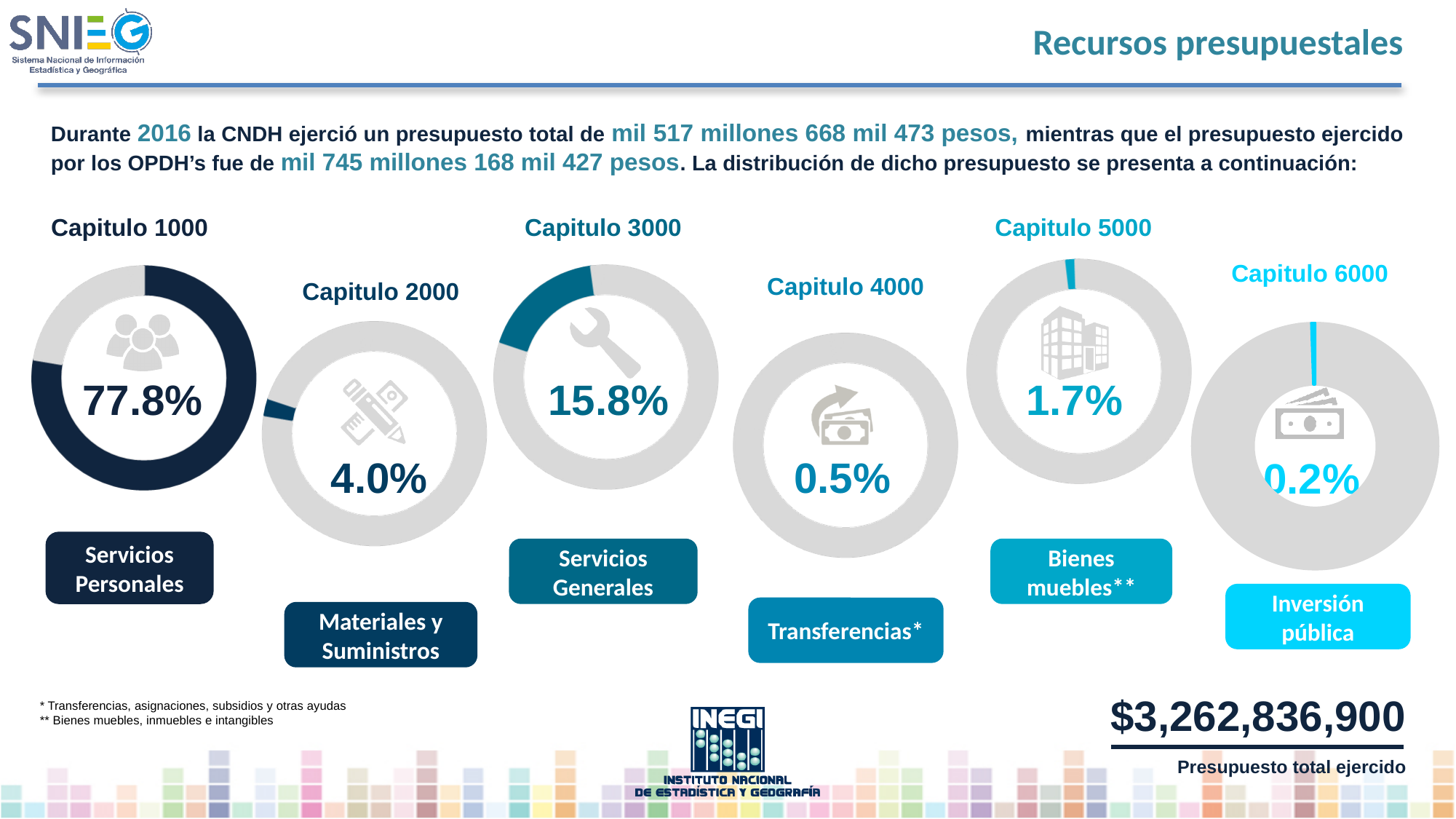
What percentage is shown in the Capitulo 1000 (Servicios Personales) donut chart? 77.8% Which capítulo has the lowest share of the budget across the donut charts? Capitulo 6000 (Inversión pública) What percentage is shown in the Capitulo 6000 (Inversión pública) donut chart? 0.2% What percentage is shown in the Capitulo 5000 (Bienes muebles) donut chart? 1.7% What percentage is shown in the Capitulo 2000 (Materiales y Suministros) donut chart? 4.0% What percentage is shown in the Capitulo 3000 (Servicios Generales) donut chart? 15.8% How many donut charts are shown on the slide? 6 What total budget amount (Presupuesto total ejercido) is shown on the slide? $3,262,836,900 Which is larger, the share for Capitulo 2000 or the share for Capitulo 5000? Capitulo 2000 Which capítulo has the highest share of the budget across the donut charts? Capitulo 1000 (Servicios Personales) What percentage is shown in the Capitulo 4000 (Transferencias) donut chart? 0.5% What is the difference in percentage points between the Capitulo 1000 and Capitulo 3000 donut charts? 62.0 percentage points